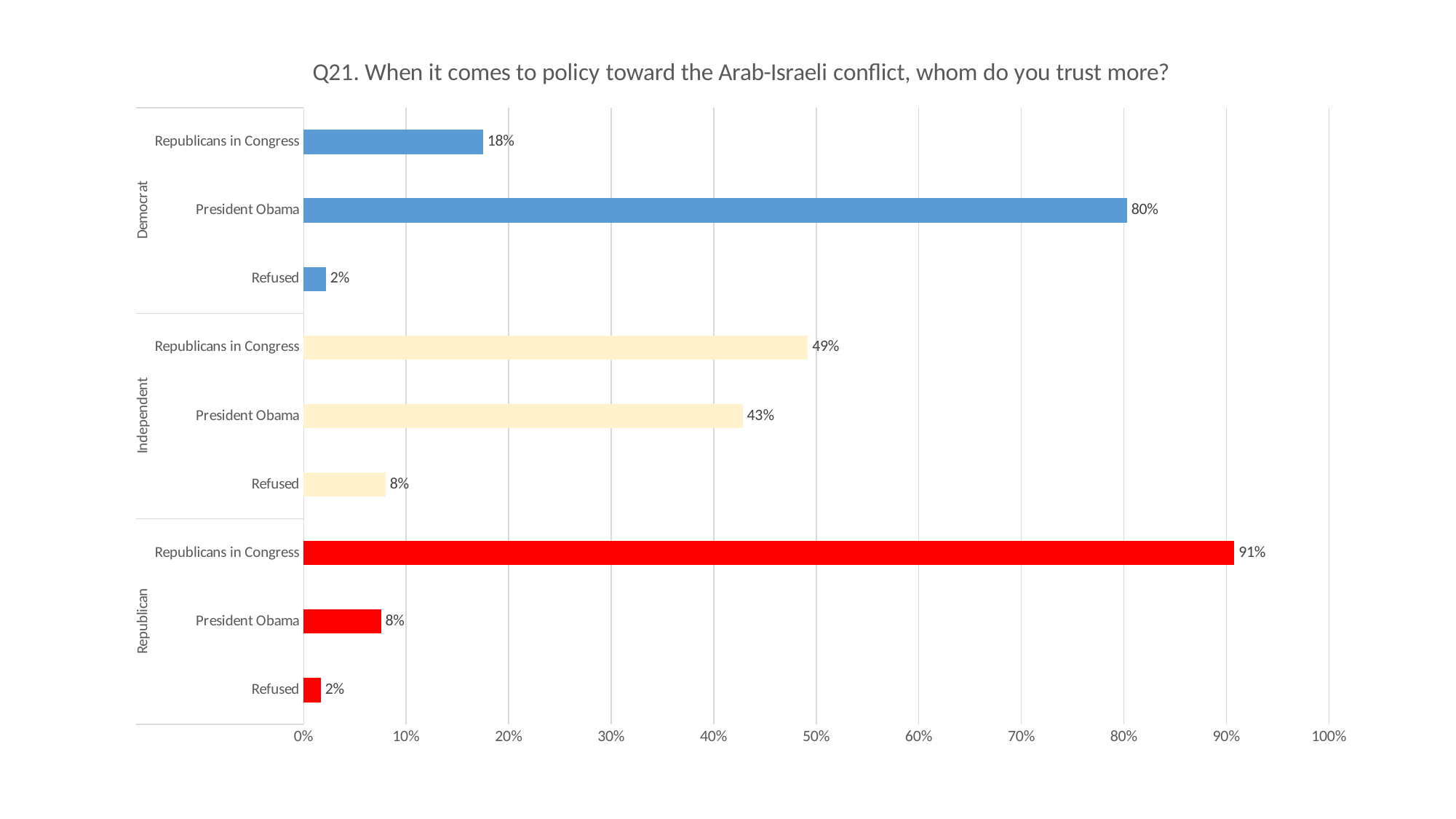
What percentage of Republicans refused to answer? 2% What percentage of Independents trust Republicans in Congress more? 49% What percentage of Democrats trust President Obama more on policy toward the Arab-Israeli conflict? 80% Is the value for President Obama among Democrats greater or less than 70%? greater Among Independents, which option has the lowest value? Refused What is the difference between the Republican and Democrat percentages for Republicans in Congress? 73 percentage points Among Independents, which is larger: the value for Republicans in Congress or for President Obama? Republicans in Congress Which bar on the chart has the highest value? Republicans in Congress (Republican), 91% What colour are the bars for the Republican group? Red What kind of chart is shown on the slide? Bar chart What is the title of the chart? Q21. When it comes to policy toward the Arab-Israeli conflict, whom do you trust more? How many bars are plotted on the chart? 9